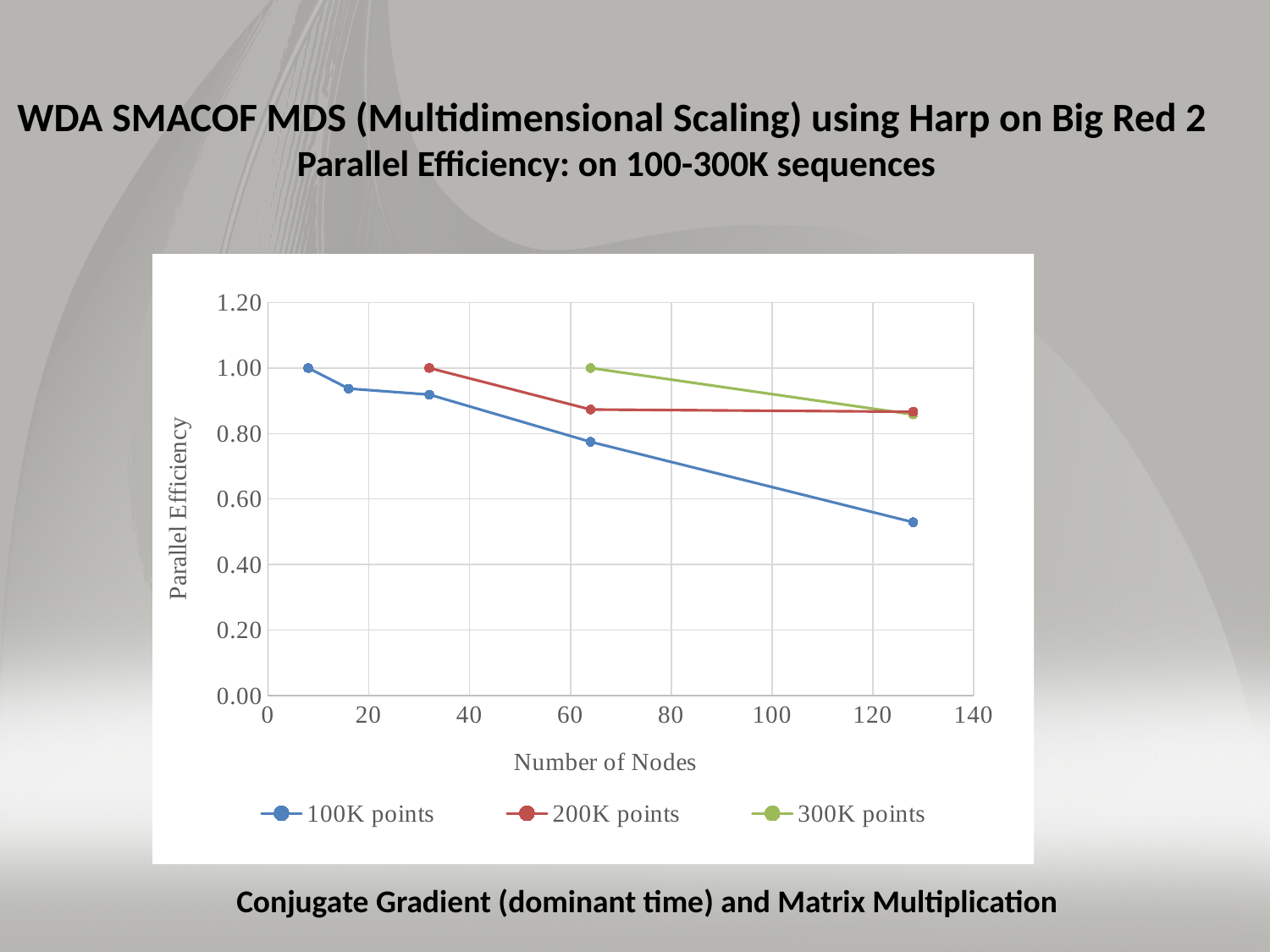
How many series does the legend list? 3 How many data points are plotted for the 300K points series? 2 What kind of chart is shown on the slide? line chart Does the parallel efficiency of the 100K points series rise or fall as the number of nodes increases? fall What is the parallel efficiency of the 300K points series at 64 nodes? 1.00 How many data points are plotted for the 100K points series? 5 At 128 nodes, which series has the lowest parallel efficiency? 100K points What is the label of the y axis? Parallel Efficiency Is the parallel efficiency of the 200K points series at 128 nodes greater or less than 0.80? greater What is the parallel efficiency of the 200K points series at 32 nodes? 1.00 Is the parallel efficiency of the 100K points series at 128 nodes greater or less than 0.60? less What is the label of the x axis? Number of Nodes